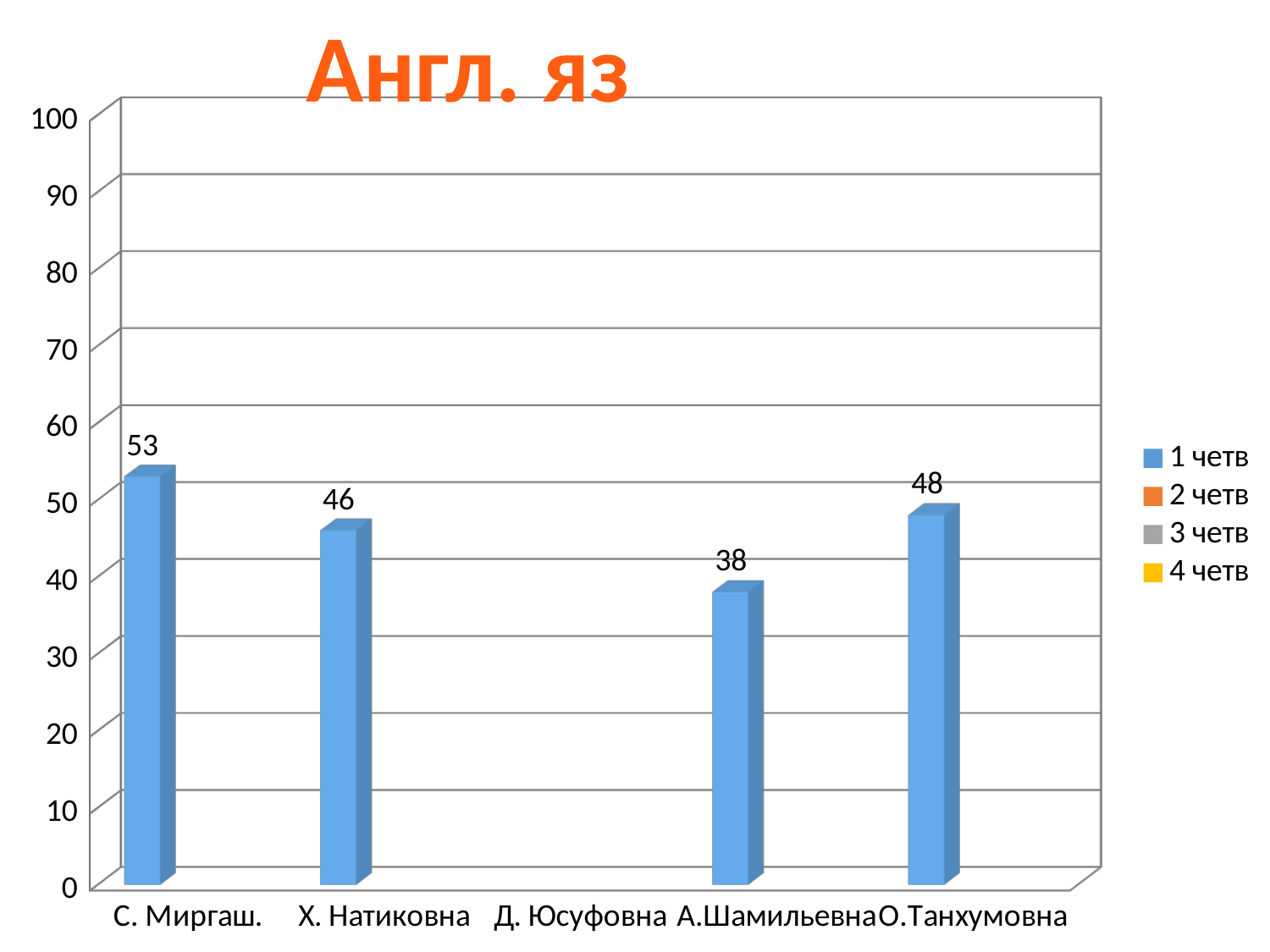
What is the value for Х. Натиковна in the 1 четв series? 46 Among the categories with a plotted bar, which has the lowest value in the 1 четв series? А.Шамильевна What is the value for С. Миргаш. in the 1 четв series? 53 What is the value for О.Танхумовна in the 1 четв series? 48 How many series does the legend list? 4 What is the value for А.Шамильевна in the 1 четв series? 38 What is the difference between the values for С. Миргаш. and А.Шамильевна? 15 What kind of chart is shown on the slide? bar chart Is the value for О.Танхумовна greater or less than 50? less Which category has the highest value in the 1 четв series? С. Миргаш. Which is larger, the value for Х. Натиковна or the value for О.Танхумовна? О.Танхумовна How many categories are shown on the x axis? 5